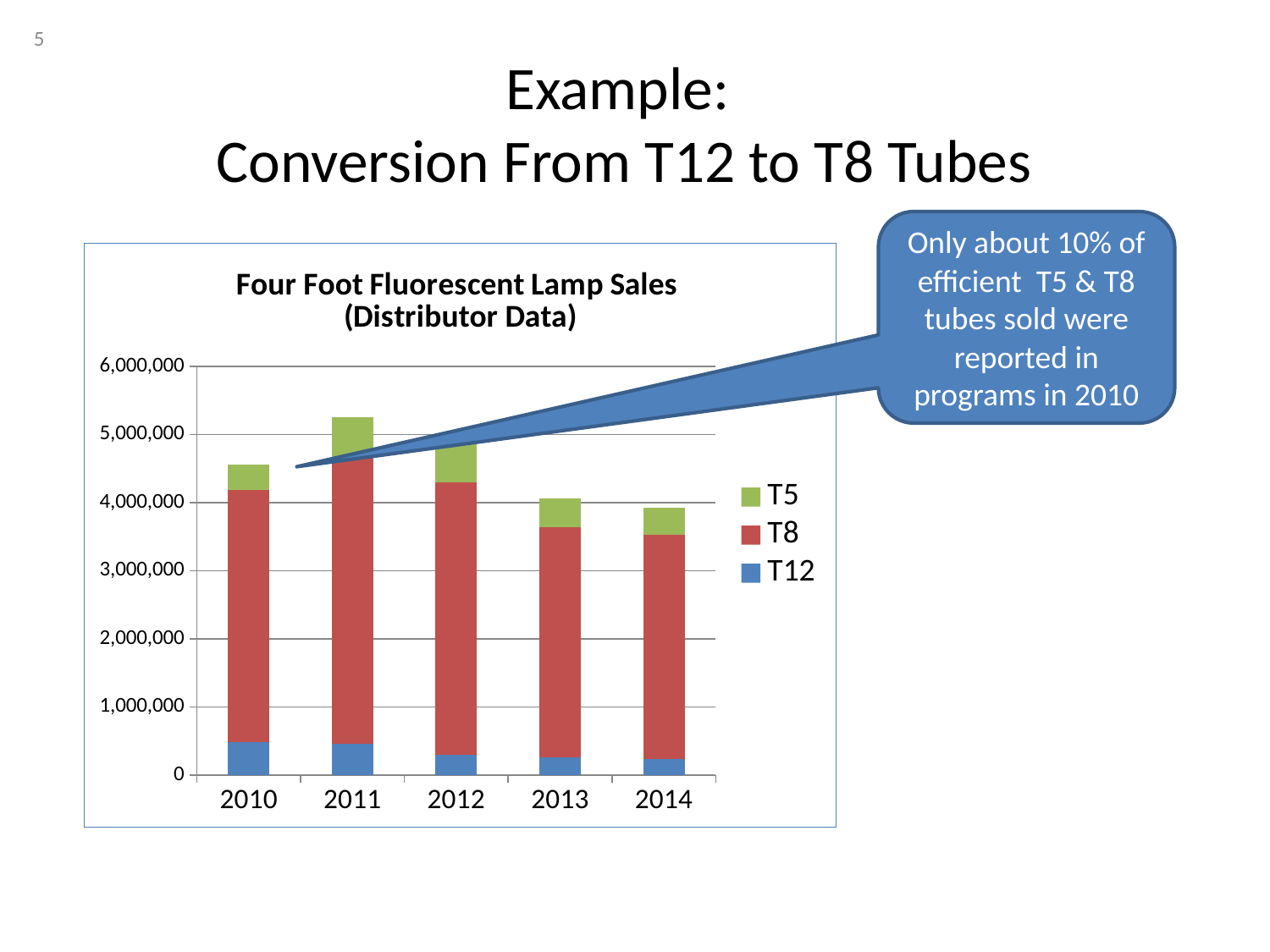
What kind of chart is shown on the slide? stacked bar chart Which year has the tallest stacked bar? 2011 Is the total stacked bar for 2011 greater or less than 5,000,000? greater Is the T12 value for 2010 greater or less than 1,000,000? less Does the T12 segment rise or fall from 2010 to 2014? fall How many series does the legend list? 3 Which is larger, the total stacked bar for 2011 or for 2013? 2011 How many years are shown on the x axis? 5 Is the total stacked bar for 2010 greater or less than 4,000,000? greater Which series are listed in the legend? T5, T8, T12 What is the title of the chart? Four Foot Fluorescent Lamp Sales (Distributor Data)